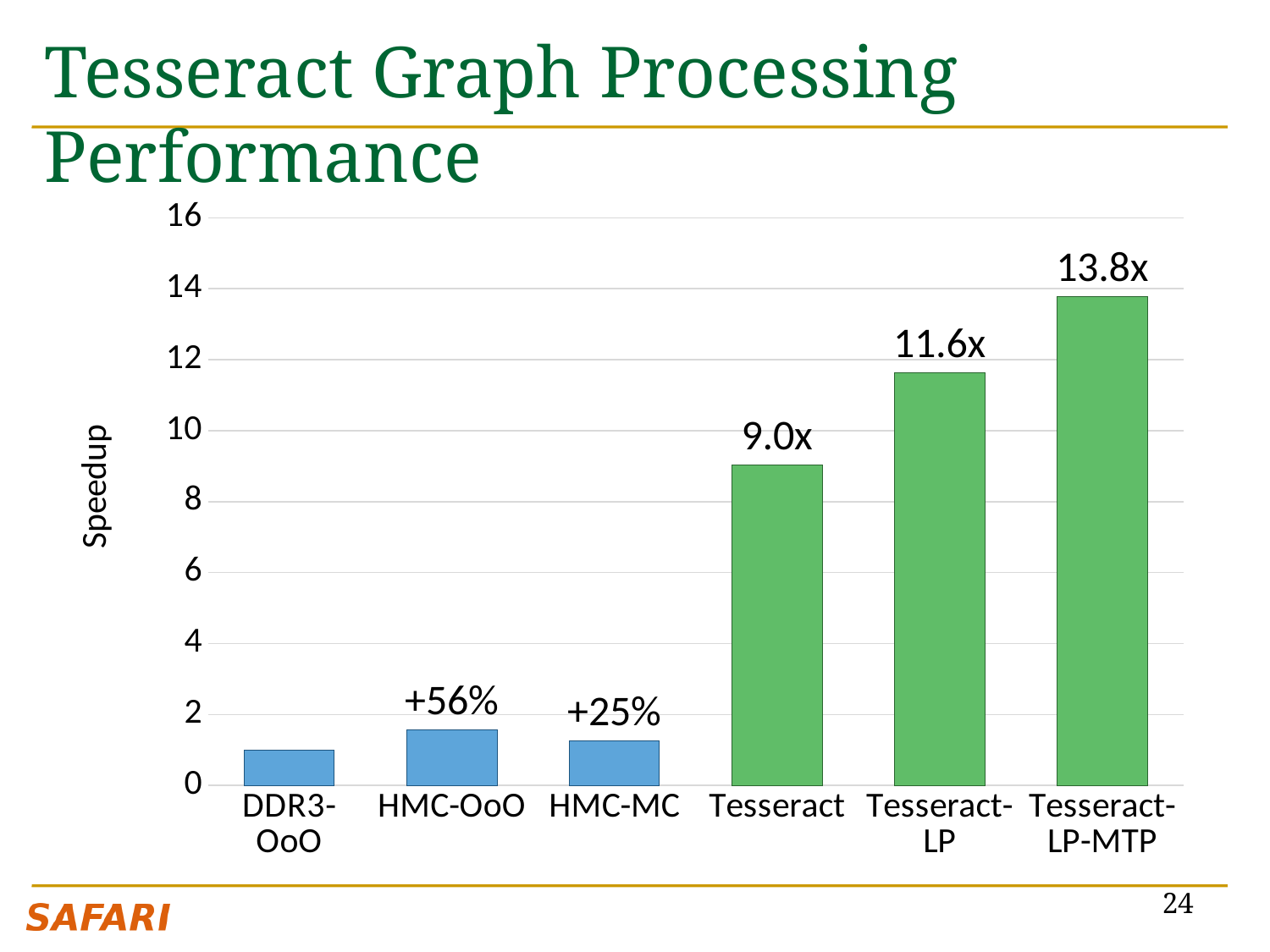
What is the speedup value labelled for Tesseract-LP? 11.6x What label is printed above the HMC-OoO bar? +56% What label is printed above the HMC-MC bar? +25% Which category has the lowest speedup? DDR3-OoO Is the speedup for DDR3-OoO greater or less than 2? less What is the title of the y axis? Speedup What is the speedup value labelled for Tesseract-LP-MTP? 13.8x Which category has the highest speedup? Tesseract-LP-MTP What is the difference between the labelled speedups of Tesseract-LP-MTP and Tesseract-LP? 2.2x What is the speedup value labelled for Tesseract? 9.0x How many categories are shown on the x axis of the chart? 6 What type of chart is shown on the slide? bar chart